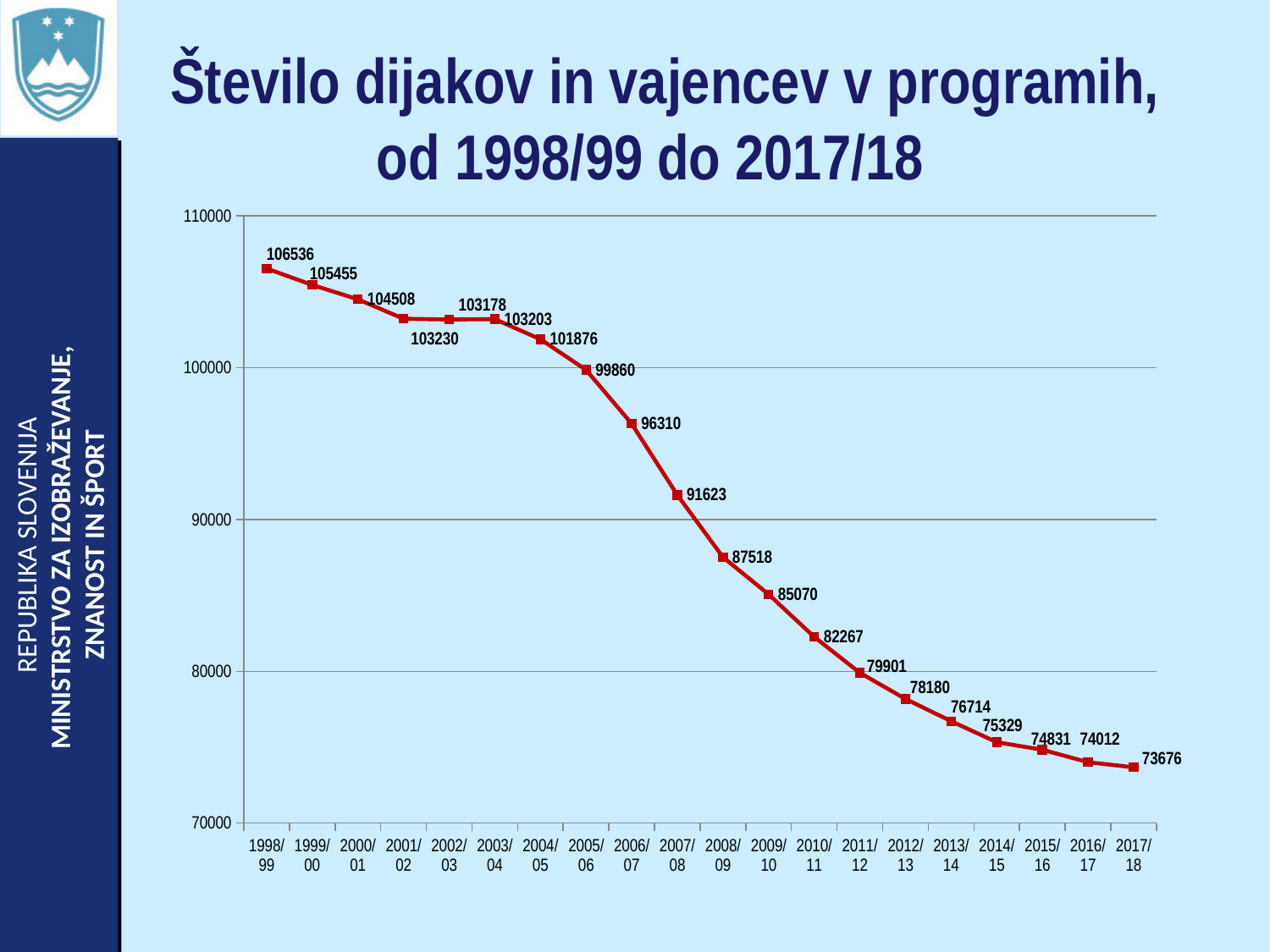
What kind of chart is shown? line chart What is the difference between the values for 1998/99 and 2017/18? 32860 What is the value for 2007/08? 91623 Which is larger, the value for 2005/06 or the value for 2006/07? 2005/06 How many school years are plotted on the x axis? 20 What is the value for 2017/18? 73676 Is the value for 2008/09 greater or less than 90000? less What is the value for 1998/99? 106536 Do the values rise or fall from 1998/99 to 2017/18? fall What is the value for 2010/11? 82267 Which school year has the highest value? 1998/99 Which school year has the lowest value? 2017/18